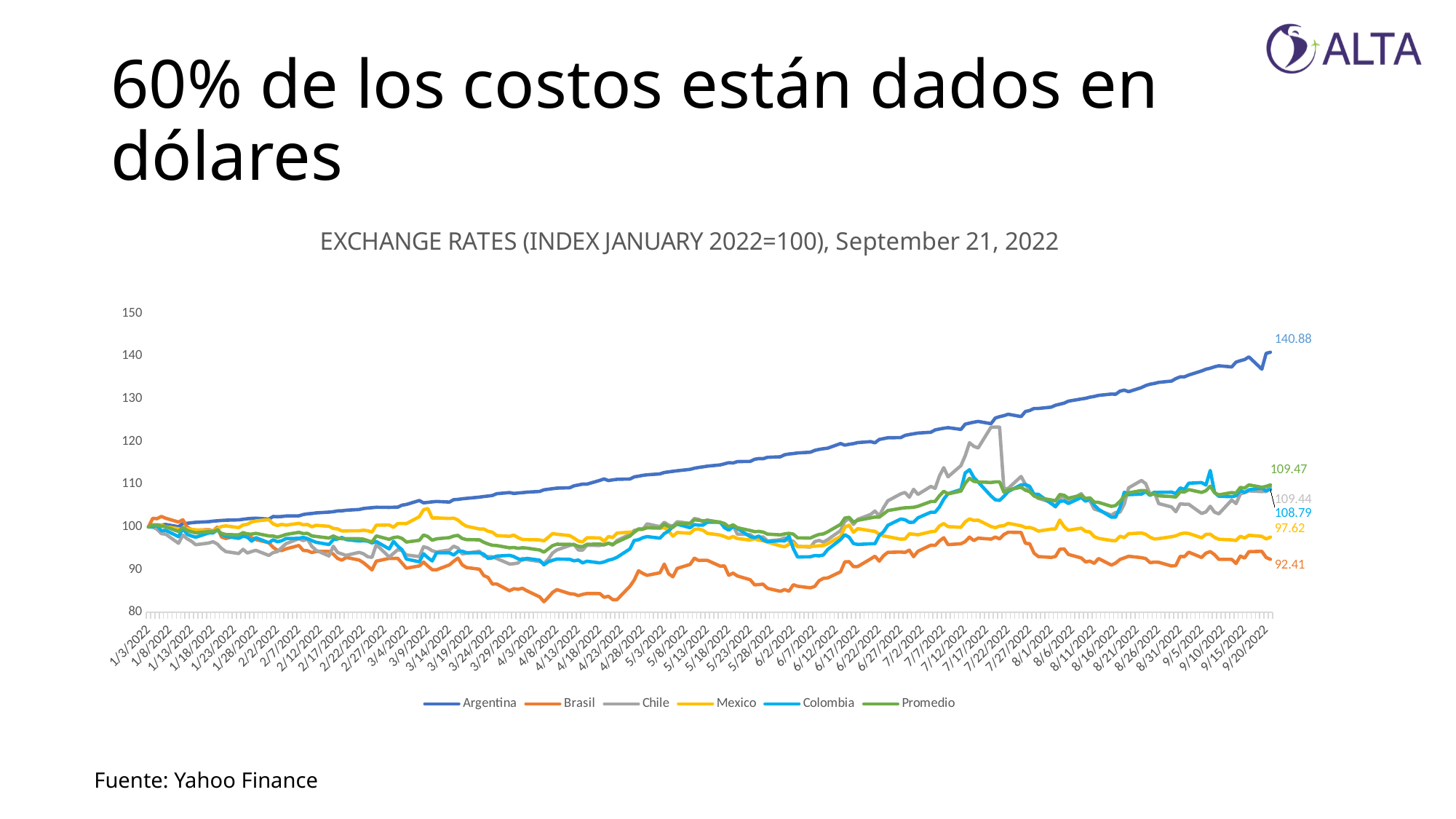
What is the final value shown for Promedio? 109.47 What is the final value shown for Argentina? 140.88 How many series does the legend list? 6 What is the difference between the final values of Argentina (140.88) and Brasil (92.41)? 48.47 Which series has the highest value at the end of the chart? Argentina What is the title of the chart? EXCHANGE RATES (INDEX JANUARY 2022=100), September 21, 2022 What is the final value shown for Mexico? 97.62 Is the final value for Colombia greater or less than 100? greater Which series has the lowest value at the end of the chart? Brasil What type of chart is shown on the slide? line chart What is the final value shown for Brasil? 92.41 Does the Argentina line rise or fall over the period shown? rise